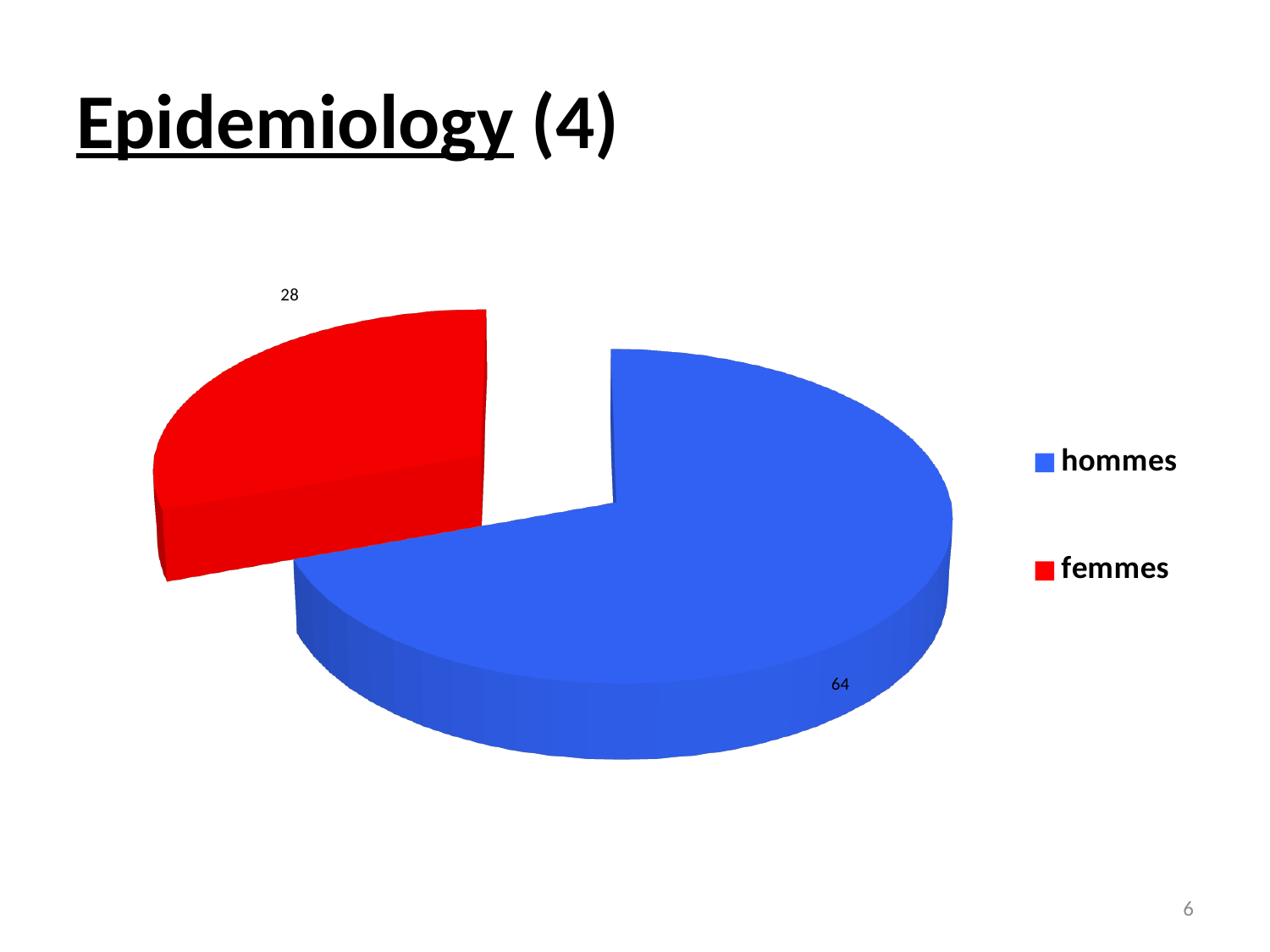
What colour is the hommes slice in the pie chart? blue Which is larger, the value for hommes or the value for femmes? hommes Which category has the smallest slice in the pie chart? femmes What is the total of the two values shown in the pie chart? 92 What colour is the femmes slice in the pie chart? red What is the difference between the values for hommes and femmes? 36 How many slices does the pie chart have? 2 How many entries does the legend list? 2 What value is shown for femmes in the pie chart? 28 What value is shown for hommes in the pie chart? 64 Which category has the largest slice in the pie chart? hommes What kind of chart is shown on the slide? pie chart